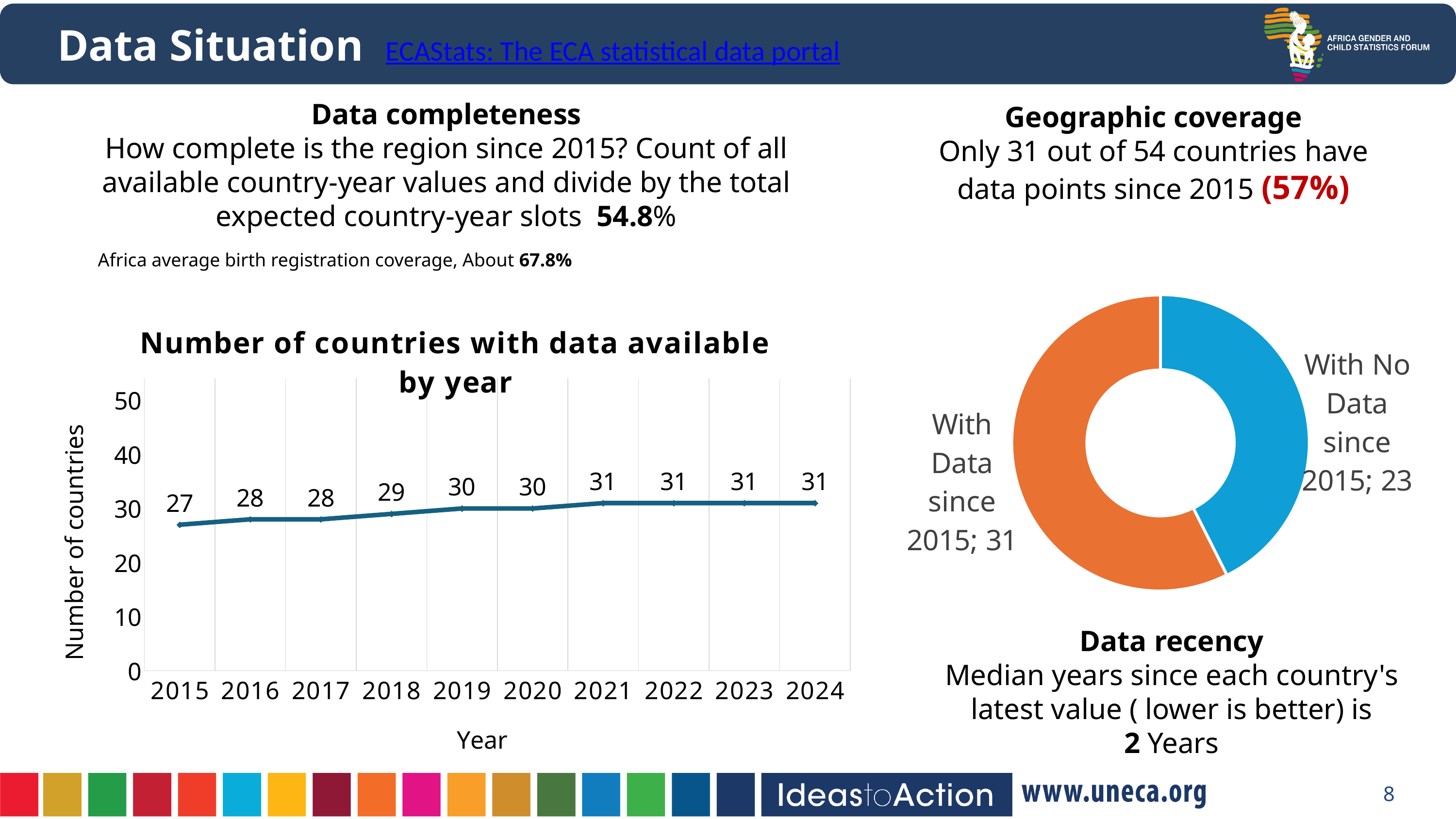
In the line chart 'Number of countries with data available by year', do the values rise or fall from 2015 to 2024? rise How many years are plotted in the line chart 'Number of countries with data available by year'? 10 In the line chart 'Number of countries with data available by year', which year has the lowest number of countries? 2015 In the line chart 'Number of countries with data available by year', is the value for 2020 greater or less than 40? less In the line chart 'Number of countries with data available by year', what is the value for 2019? 30 What kind of chart is 'Number of countries with data available by year'? line chart In the donut chart on the right of the slide, which segment is larger, 'With Data since 2015' or 'With No Data since 2015'? With Data since 2015 In the line chart 'Number of countries with data available by year', what is the value for 2015? 27 In the line chart 'Number of countries with data available by year', what is the difference between the values for 2024 and 2015? 4 In the donut chart on the right of the slide, how many countries are 'With No Data since 2015'? 23 In the line chart 'Number of countries with data available by year', which is larger, the value for 2018 or the value for 2021? 2021 What is the label of the y axis in the line chart 'Number of countries with data available by year'? Number of countries